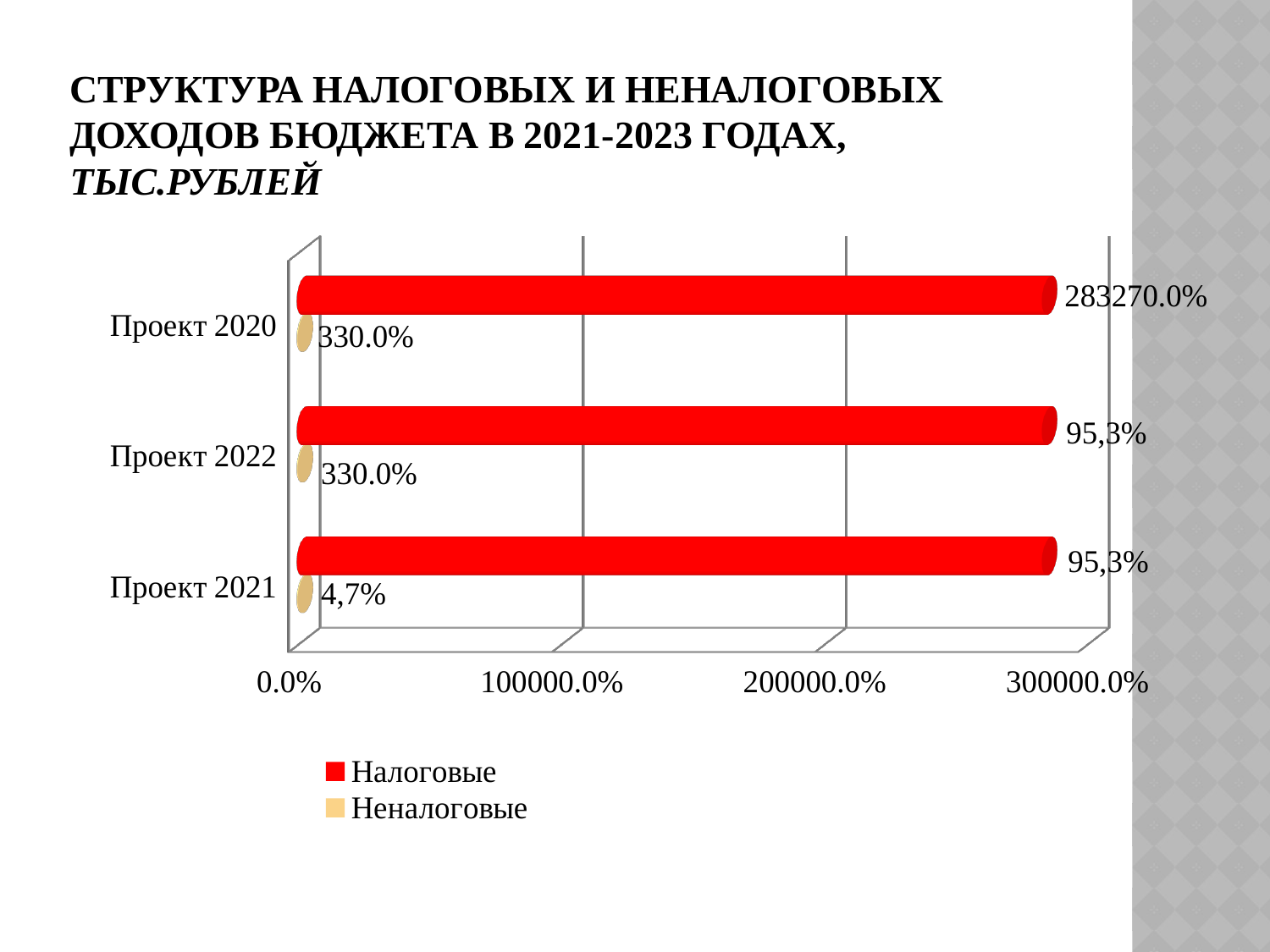
What is the data label for Налоговые for Проект 2020? 283270.0% Which series is shown in red in the legend? Налоговые What is the data label for Неналоговые for Проект 2020? 330.0% Is the Неналоговые bar for Проект 2020 greater or less than 100000.0% on the axis? less What is the data label for Неналоговые for Проект 2022? 330.0% What is the data label for Неналоговые for Проект 2021? 4,7% How many categories (projects) are shown on the chart? 3 For Проект 2021, which bar is longer: Налоговые or Неналоговые? Налоговые How many series does the legend list? 2 What kind of chart is shown on the slide? bar chart Is the Налоговые bar for Проект 2022 greater or less than 200000.0% on the axis? greater What is the data label for Налоговые for Проект 2022? 95,3%